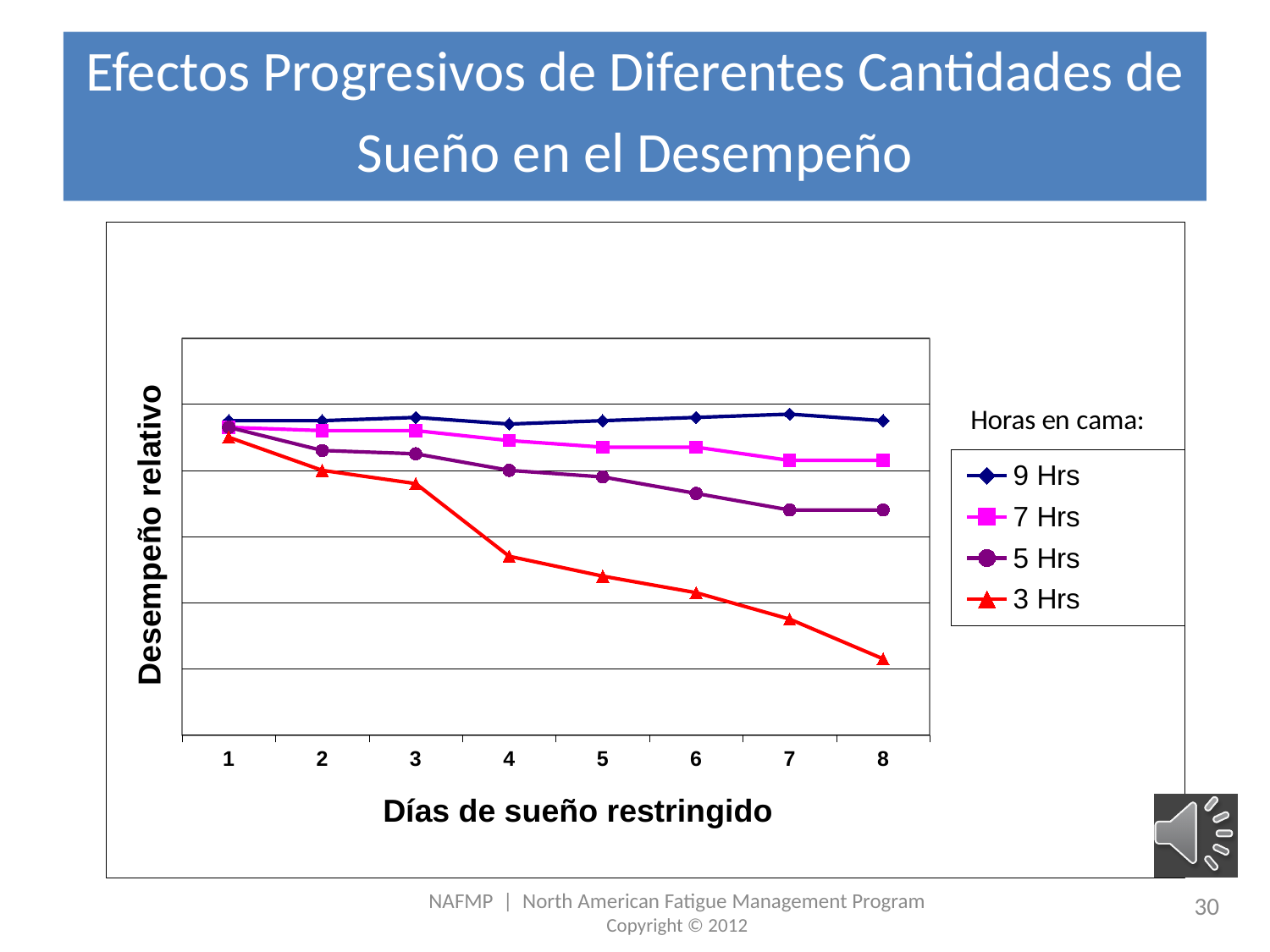
What is the title of the x axis? Días de sueño restringido Which series has the highest value on day 8? 9 Hrs On day 6, which is larger: the value for 7 Hrs or the value for 3 Hrs? 7 Hrs Which series shows the steepest decline over the eight days? 3 Hrs Which series has the lowest value on day 8? 3 Hrs Does the value for the 3 Hrs series rise or fall as the days of restricted sleep increase? fall On day 4, which is larger: the value for 5 Hrs or the value for 3 Hrs? 5 Hrs How many series does the legend list? 4 How many days are shown along the x axis? 8 Does the value for the 5 Hrs series rise or fall from day 1 to day 8? fall What is the title of the y axis? Desempeño relativo What kind of chart is shown on the slide? line chart